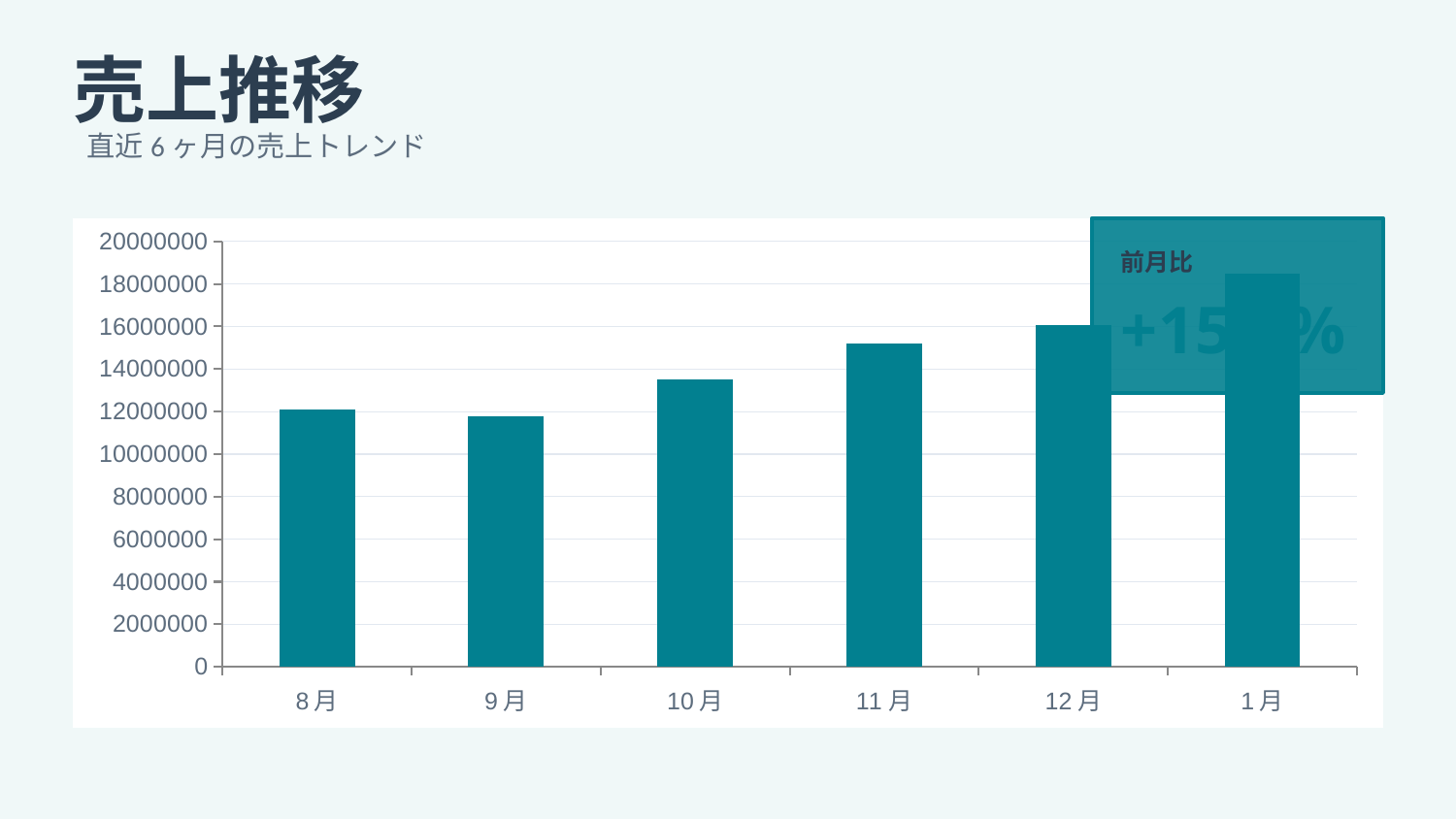
Is the value for 1月 greater or less than 16000000? greater How many months are plotted on the chart? 6 Is the value for 9月 greater or less than 12000000? less Do the values generally rise or fall from 9月 to 1月? rise Which month has the highest bar? 1月 What kind of chart is shown on the slide? bar chart Which is larger, the value for 12月 or the value for 11月? 12月 Is the value for 10月 greater or less than 12000000? greater What is the title of the slide containing the chart? 売上推移